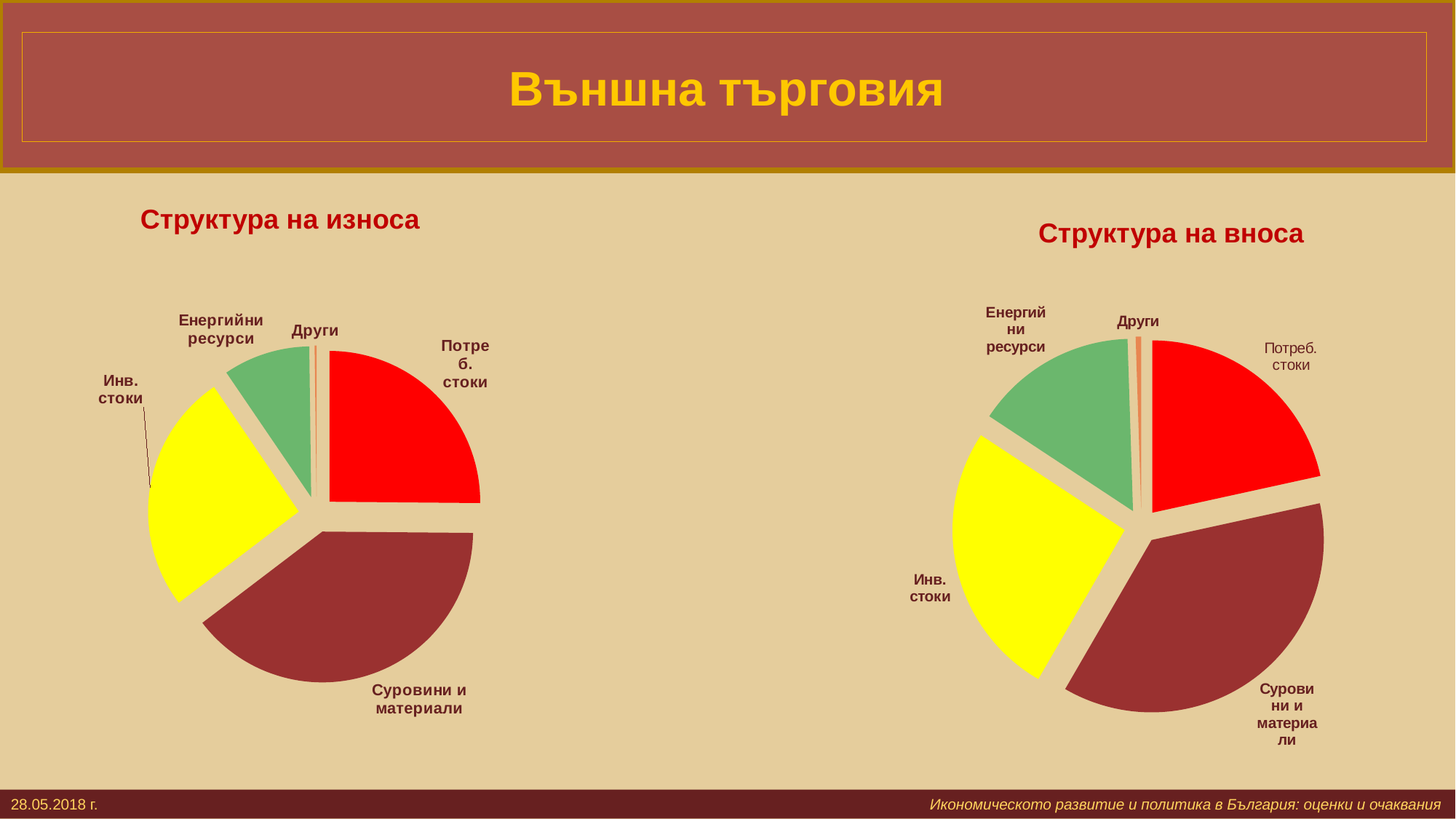
What kind of chart is "Структура на вноса"? pie chart In the "Структура на износа" chart, which category has the smallest slice? Други In the "Структура на вноса" chart, which slice is larger: Потреб. стоки or Енергийни ресурси? Потреб. стоки In the "Структура на износа" chart, what colour is the Суровини и материали slice? dark red How many slices does the "Структура на износа" pie chart have? 5 What is the title of the pie chart on the right side of the slide? Структура на вноса In the "Структура на вноса" chart, which category has the smallest slice? Други In the "Структура на износа" chart, which category has the largest slice? Суровини и материали In the "Структура на износа" chart, which slice is larger: Инв. стоки or Енергийни ресурси? Инв. стоки What kind of chart is "Структура на износа"? pie chart In the "Структура на вноса" chart, which category has the largest slice? Суровини и материали How many slices does the "Структура на вноса" pie chart have? 5